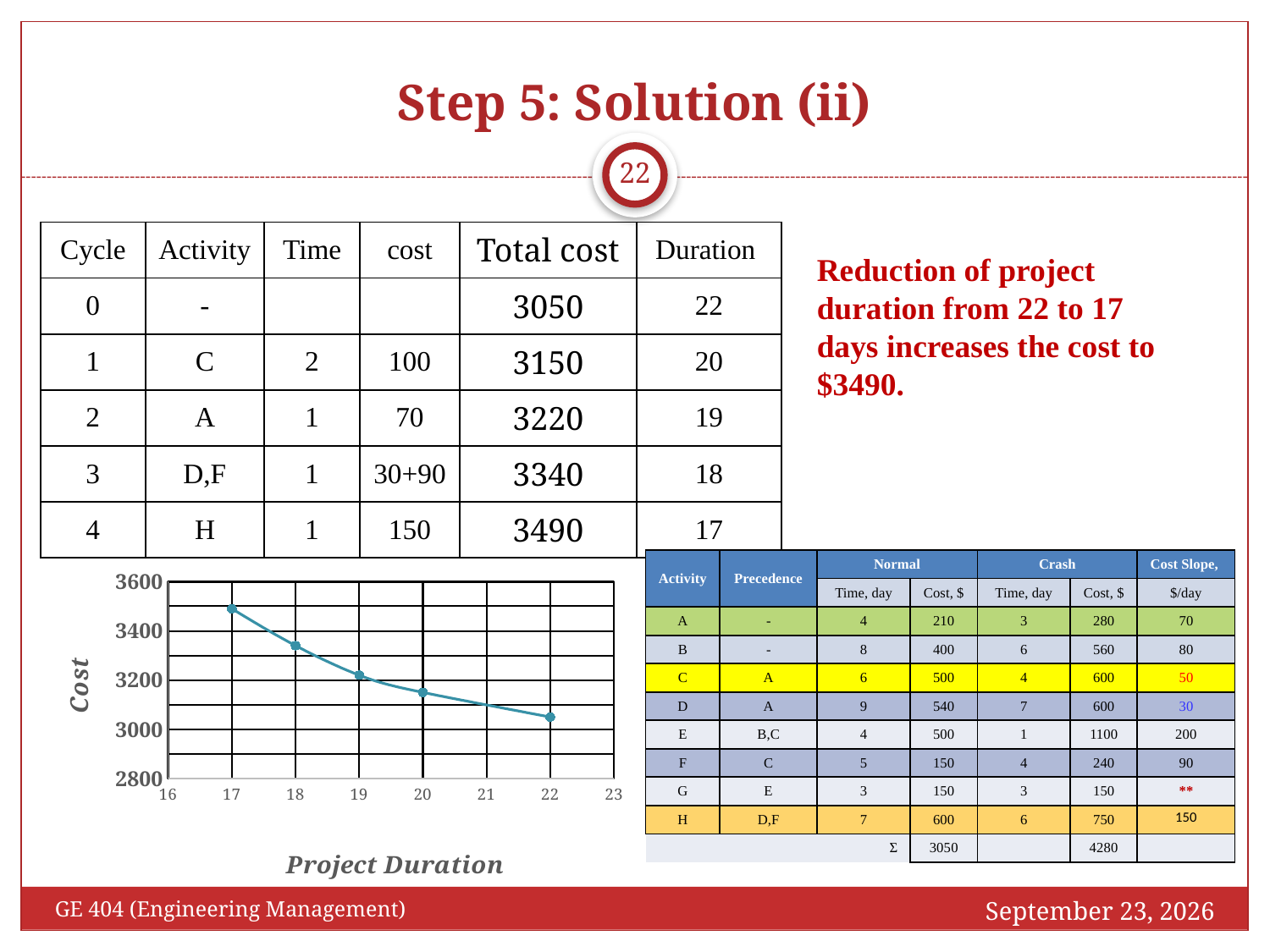
On the Cost vs Project Duration chart, is the cost at a duration of 22 greater or less than 3200? less On the Cost vs Project Duration chart, is the cost at a duration of 17 greater or less than 3400? greater What is the label of the vertical axis on the chart? Cost What kind of chart is shown at the bottom left of the slide? line chart How many data points are plotted on the Cost vs Project Duration chart? 5 On the Cost vs Project Duration chart, at which project duration is the plotted cost lowest? 22 On the Cost vs Project Duration chart, is the cost at a duration of 20 greater or less than 3000? greater On the Cost vs Project Duration chart, does the cost rise or fall as project duration increases along the x axis? fall What is the label of the horizontal axis on the chart? Project Duration On the Cost vs Project Duration chart, at which project duration is the plotted cost highest? 17 On the Cost vs Project Duration chart, which has the larger cost: a duration of 18 or a duration of 20? 18